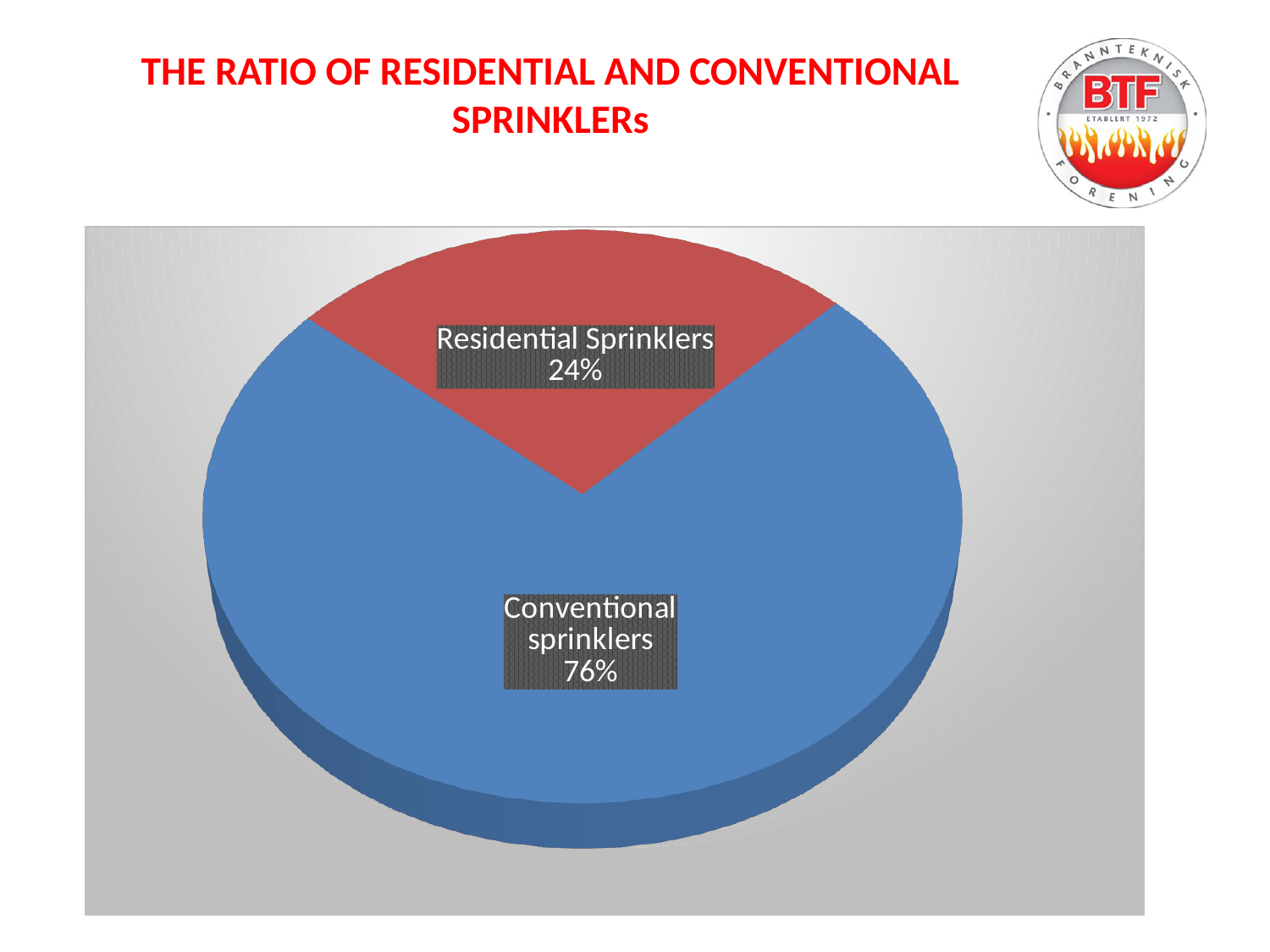
What is the title of the slide containing the chart? THE RATIO OF RESIDENTIAL AND CONVENTIONAL SPRINKLERs What share of the pie is Residential Sprinklers? 24% Which slice of the pie is the largest? Conventional sprinklers What kind of chart is shown on the slide? Pie chart Which slice of the pie is the smallest? Residential Sprinklers Which is larger, the share for Residential Sprinklers or the share for Conventional sprinklers? Conventional sprinklers What colour is the Residential Sprinklers slice? Red How many slices does the pie chart have? 2 What is the difference in percentage points between Conventional sprinklers and Residential Sprinklers? 52 What share of the pie is Conventional sprinklers? 76%